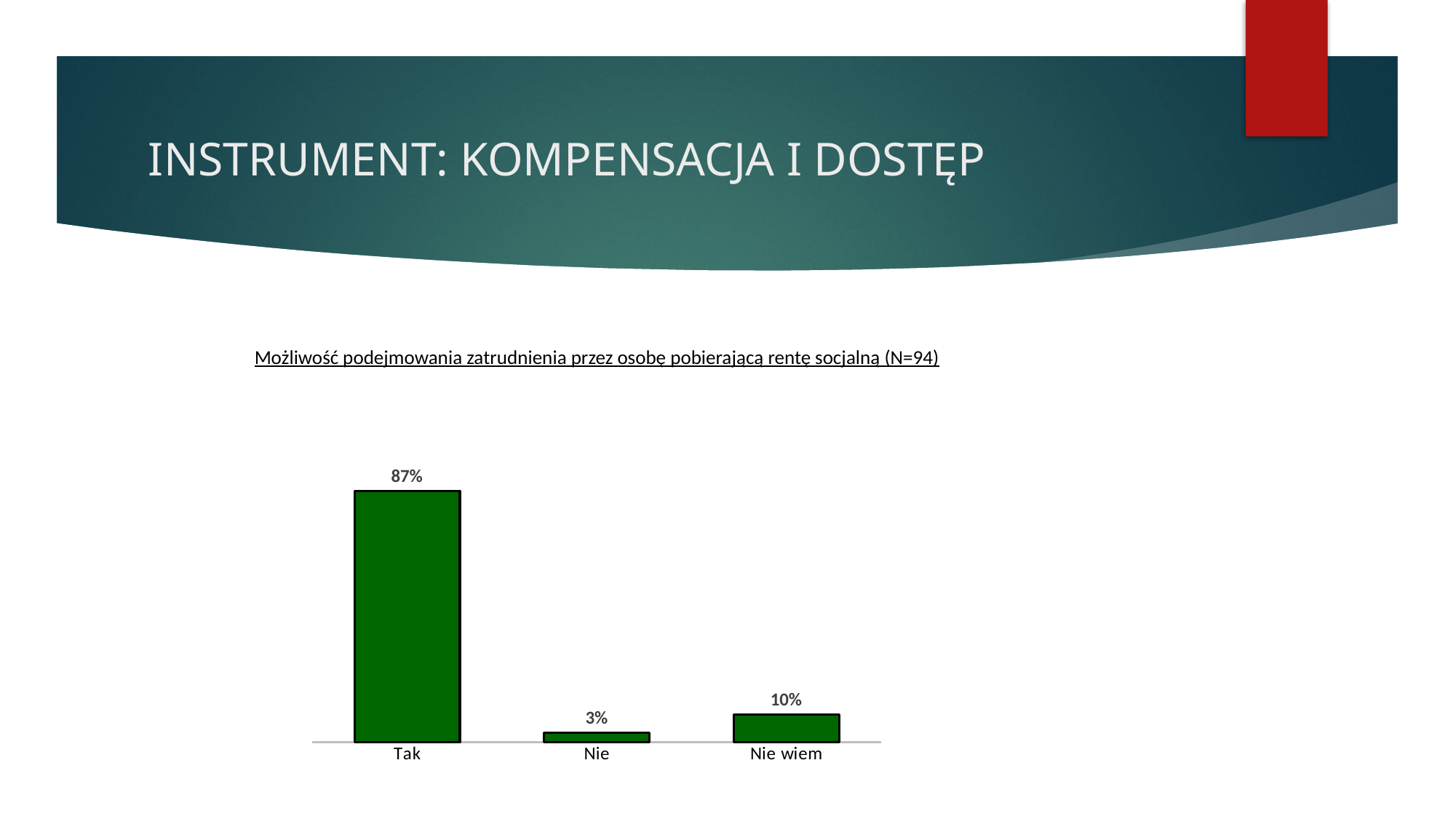
What kind of chart is shown on the slide? Bar chart What is the value for Nie? 3% How many categories are shown in the chart? 3 What is the value for Tak? 87% What is the sample size (N) stated in the chart title? 94 What is the difference between the values for Nie wiem and Nie? 7% What is the value for Nie wiem? 10% What colour are the bars in the chart? Green Which category has the highest value? Tak Which category has the lowest value? Nie Which is larger, the value for Nie or the value for Nie wiem? Nie wiem What is the difference between the values for Tak and Nie wiem? 77%